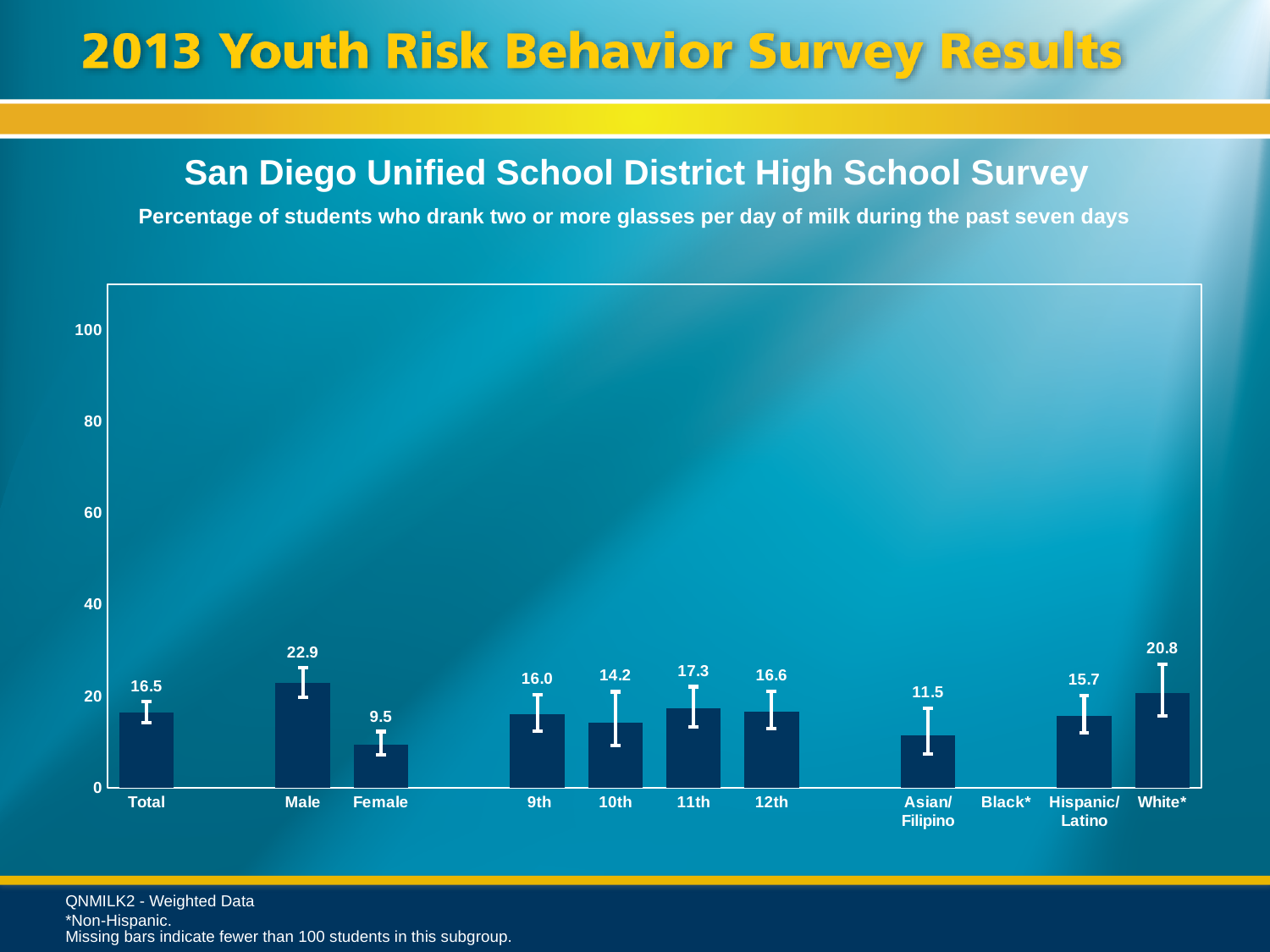
What kind of chart is this? bar chart Is the value for White* greater or less than 20? greater What is the value for Total? 16.5 Which category has the lowest value among the plotted bars? Female Which category has the highest value? Male What is the value for Male? 22.9 Which is larger, the value for 11th or the value for 10th? 11th Which category has no bar plotted? Black* What is the difference between the values for Male and Female? 13.4 What is the value for Female? 9.5 How many categories are labeled on the x axis? 11 What is the value for Asian/Filipino? 11.5